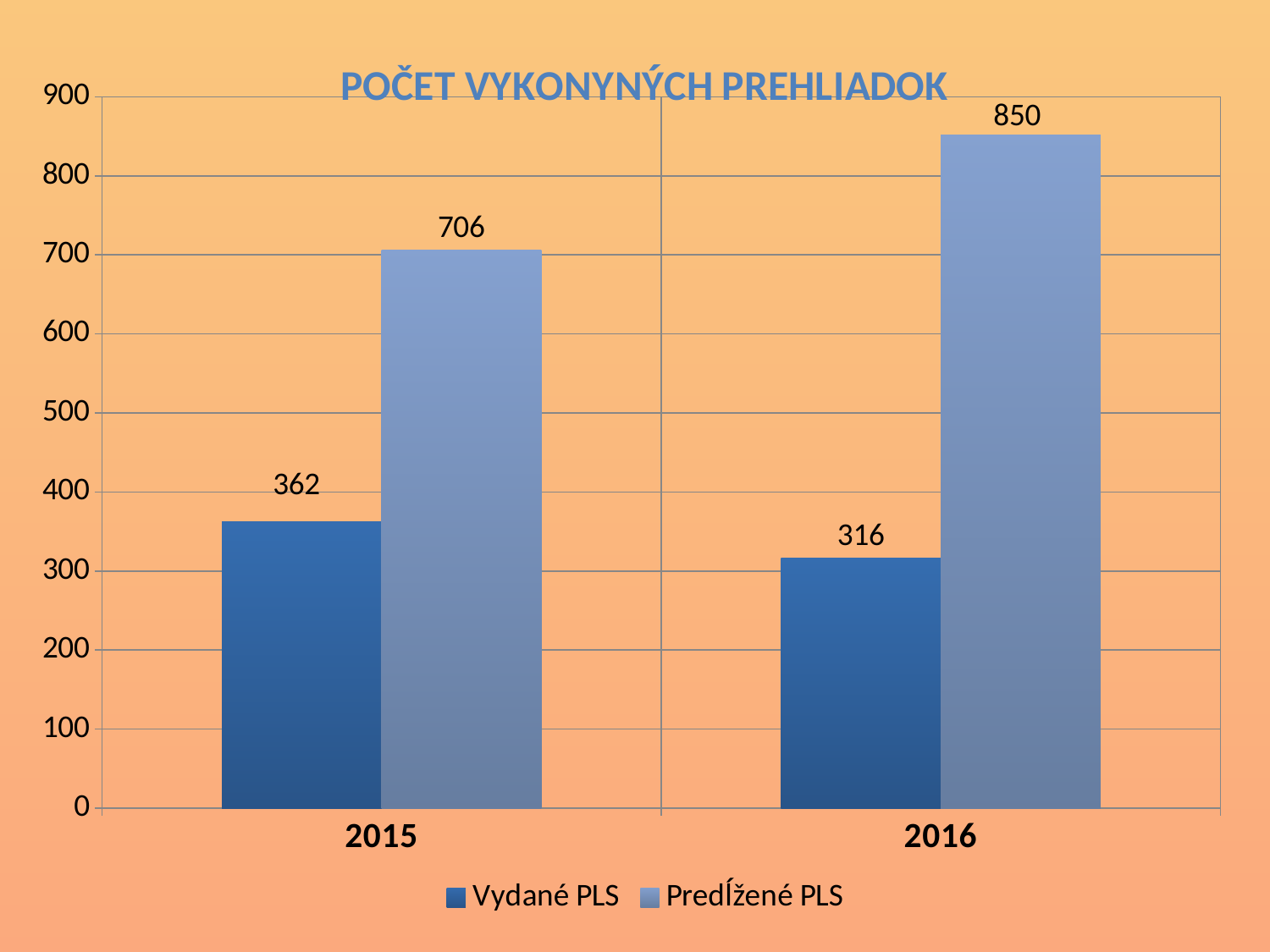
Which year has the lowest value for Vydané PLS? 2016 What is the value for Predĺžené PLS in 2015? 706 How many years are shown on the x axis? 2 What is the value for Vydané PLS in 2015? 362 What is the difference between Predĺžené PLS in 2016 and Predĺžené PLS in 2015? 144 What kind of chart is shown on the slide? Bar chart What is the title of the chart? POČET VYKONYNÝCH PREHLIADOK What is the value for Vydané PLS in 2016? 316 What is the value for Predĺžené PLS in 2016? 850 Which is larger in 2015: Vydané PLS or Predĺžené PLS? Predĺžené PLS How many series does the legend list? 2 Which year has the highest value for Predĺžené PLS? 2016